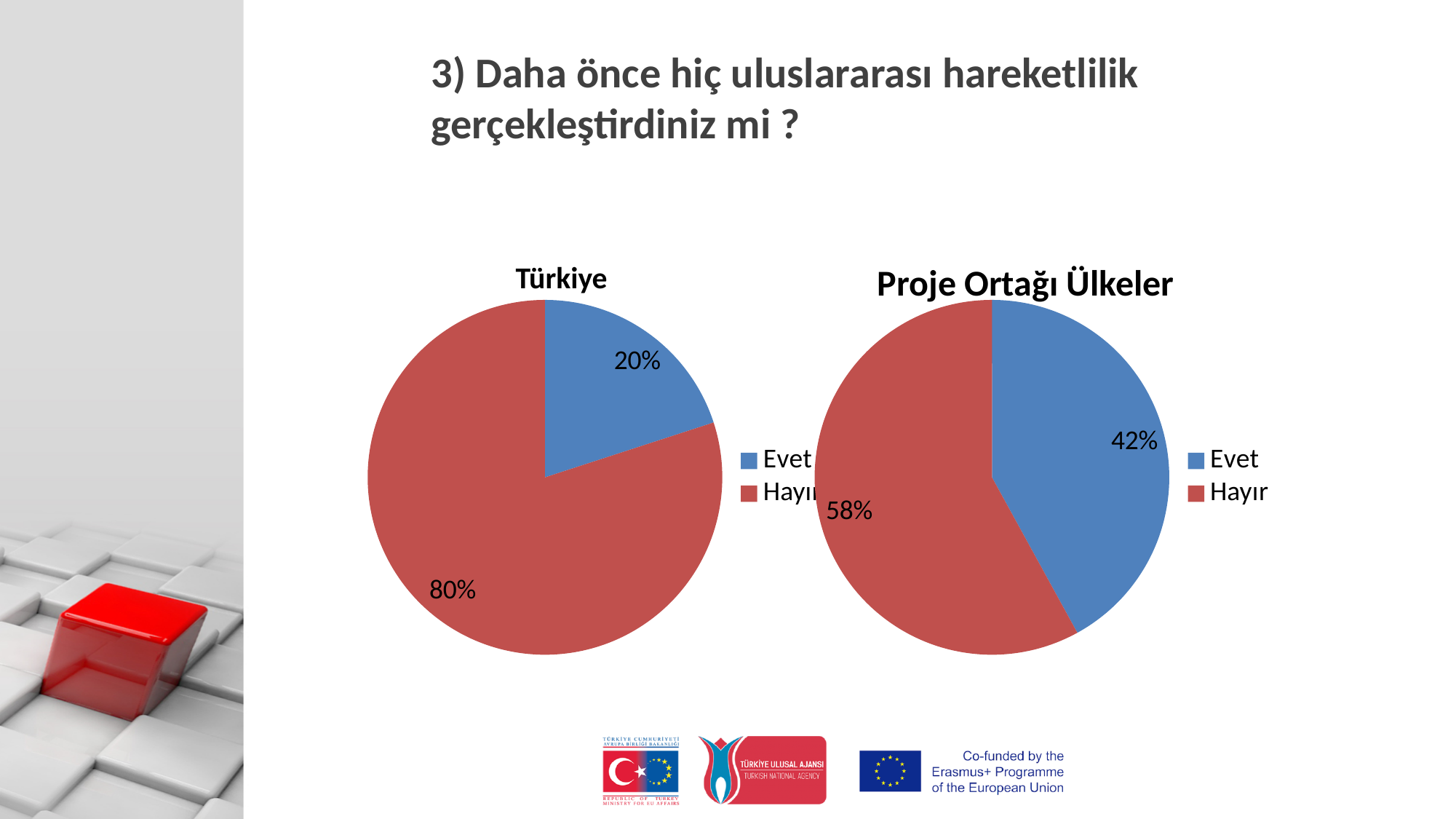
What type of chart is used for Türkiye and Proje Ortağı Ülkeler? Pie chart In the Türkiye pie chart, what share is labelled for Evet? 20% In the Türkiye pie chart, what is the difference between the Hayır and Evet shares? 60% In the Proje Ortağı Ülkeler pie chart, what share is labelled for Evet? 42% In the Proje Ortağı Ülkeler pie chart, what is the difference between the Hayır and Evet shares? 16% In the Türkiye pie chart, what share is labelled for Hayır? 80% In the Türkiye pie chart, which colour represents Hayır? Red In the Proje Ortağı Ülkeler pie chart, which slice is the smallest? Evet How many entries does the legend of the Proje Ortağı Ülkeler chart list? 2 In the Proje Ortağı Ülkeler pie chart, what share is labelled for Hayır? 58% In the Türkiye pie chart, which slice is the largest? Hayır Is the Evet share larger in the Türkiye chart or in the Proje Ortağı Ülkeler chart? Proje Ortağı Ülkeler